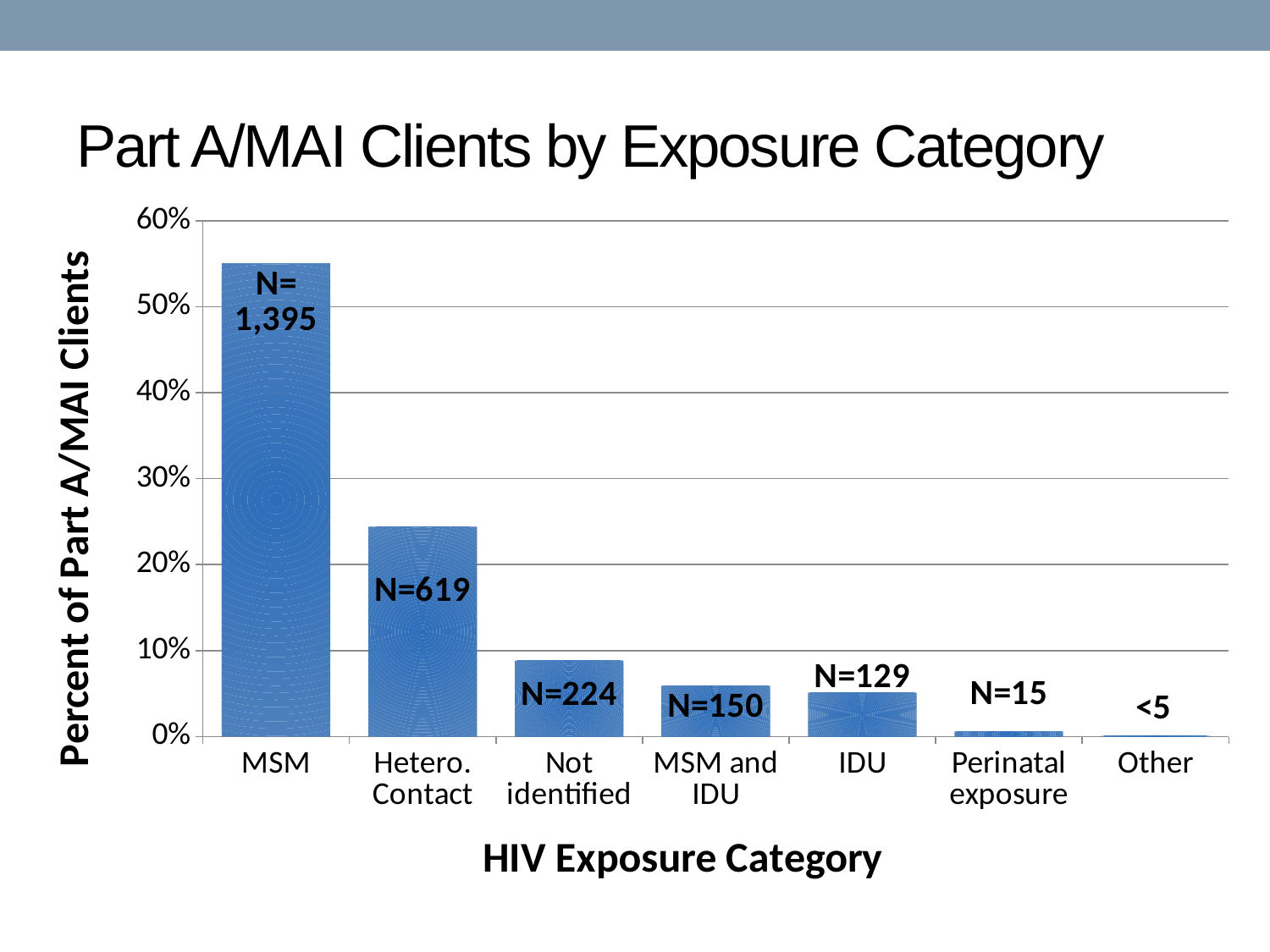
How many HIV exposure categories are shown on the x axis? 7 Which exposure category has the lowest percent of Part A/MAI clients? Other Is the percent of clients for Hetero. Contact greater or less than 30%? less What N value is labelled on the Hetero. Contact bar? N=619 What label is shown on the Other bar? <5 Is the percent of clients for MSM greater or less than 50%? greater What kind of chart is shown on the slide? bar chart Which has a higher percent of clients, Not identified or MSM and IDU? Not identified What is the difference between the N for Not identified and the N for MSM and IDU? 74 What N value is labelled on the IDU bar? N=129 What N value is labelled on the MSM bar? N=1,395 Which exposure category has the highest percent of Part A/MAI clients? MSM